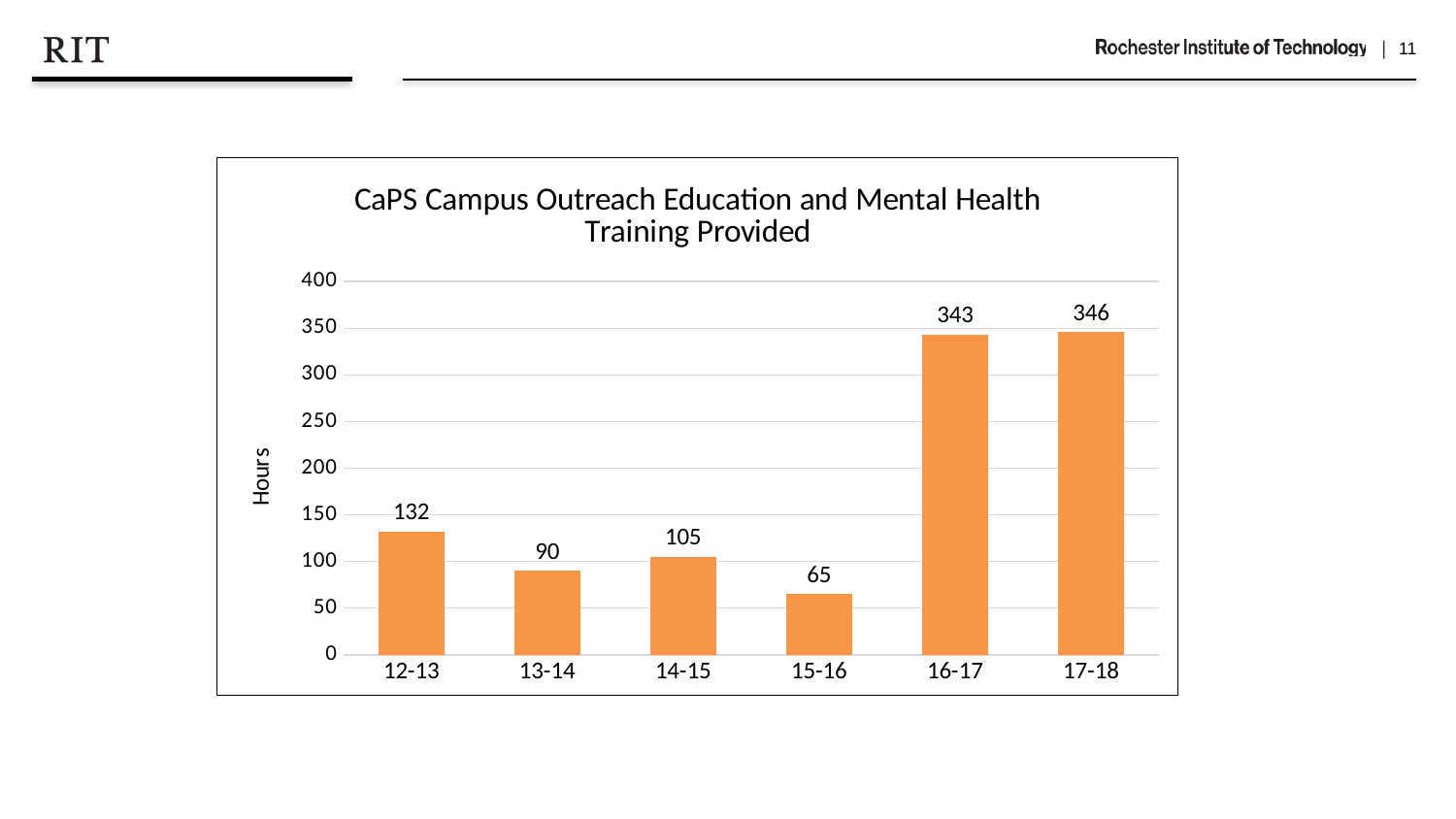
What is the difference between the values for 12-13 and 13-14? 42 What is the value for 12-13? 132 Which year has the lowest value? 15-16 How many hours are shown for 15-16? 65 Is the value for 16-17 greater or less than 300? greater Which is larger, the value for 14-15 or the value for 13-14? 14-15 Which year has the highest value? 17-18 How many years are shown on the x axis? 6 What kind of chart is this? bar chart What is the difference between the values for 17-18 and 16-17? 3 What is the value for 16-17? 343 What is the label on the vertical axis? Hours